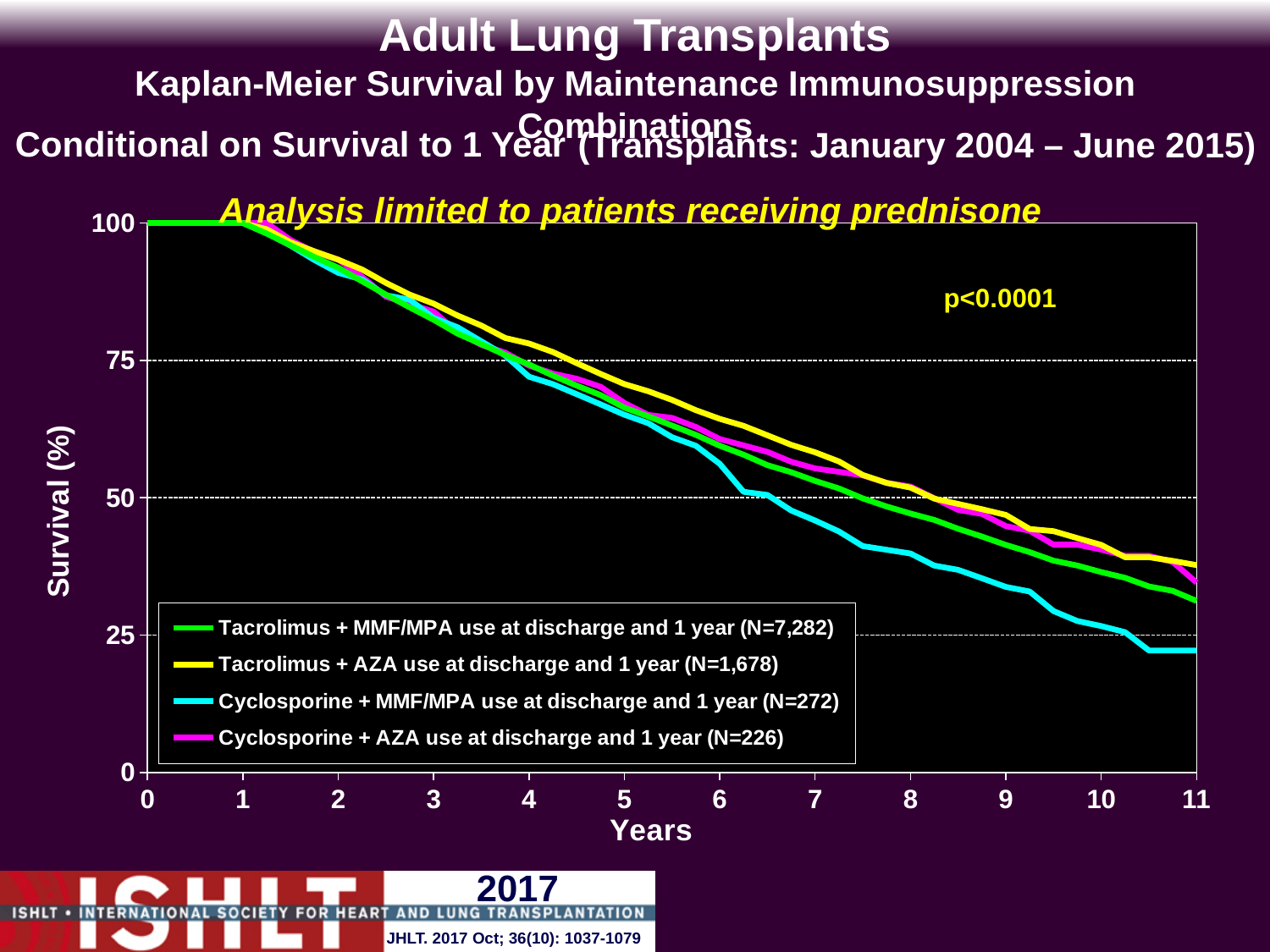
Do the survival curves rise or fall as years increase? fall What kind of chart is shown on the slide? line chart At year 8, which group has higher survival: Tacrolimus + AZA or Cyclosporine + MMF/MPA? Tacrolimus + AZA How many series does the legend list? 4 Which group has the lowest survival at year 11? Cyclosporine + MMF/MPA use at discharge and 1 year What is the N for the Tacrolimus + MMF/MPA group in the legend? 7,282 Is the survival for Tacrolimus + AZA at year 11 greater or less than 25? greater What p-value is shown on the chart? p<0.0001 Is the survival for Cyclosporine + MMF/MPA at year 11 greater or less than 25? less Is the survival for Cyclosporine + MMF/MPA at year 8 greater or less than 50? less What is the survival (%) for all four groups at year 1? 100